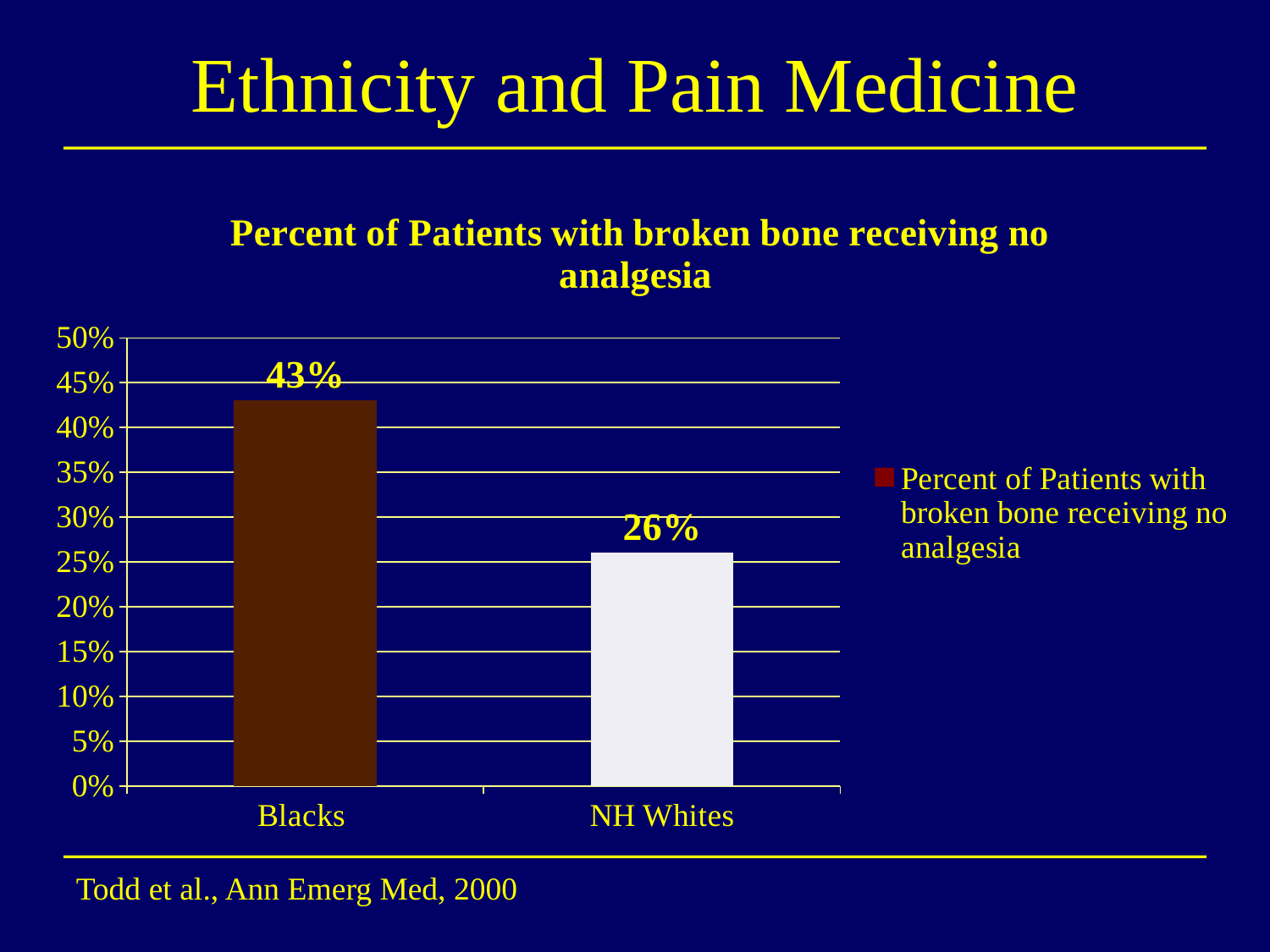
What is the value for Blacks? 43% How many series does the legend list? 1 What is the value for NH Whites? 26% Is the value for NH Whites greater or less than 30%? less What is the title of the chart? Percent of Patients with broken bone receiving no analgesia Which category has the lowest value? NH Whites Which category has the highest value? Blacks Is the value for Blacks greater or less than 40%? greater What is the difference between the values for Blacks and NH Whites? 17% How many categories are shown on the x axis? 2 What kind of chart is shown? bar chart Which is larger, the value for Blacks or the value for NH Whites? Blacks